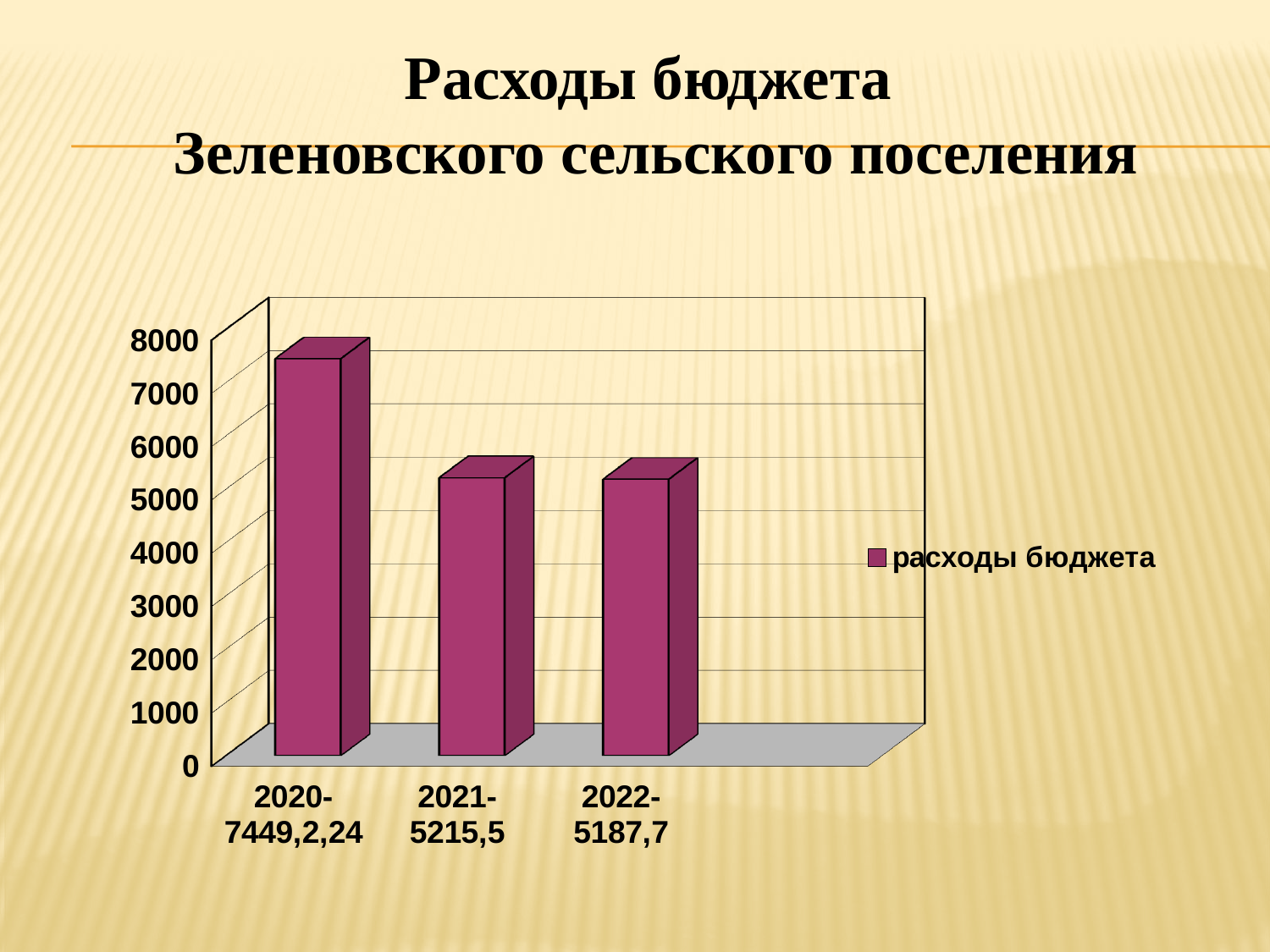
Which year has the highest budget expenditure in the chart? 2020 Is the value for 2022 greater or less than 6000? less Is the value for 2020 greater or less than 7000? greater What kind of chart is shown on the slide? bar chart Is the value for 2021 greater or less than 5000? greater Do the values rise or fall from 2020 to 2022 along the x axis? fall How many series does the legend list? 1 How many bars (categories) are plotted in the chart? 3 What value is printed in the category label for 2022? 5187,7 Which is larger, the value for 2020 or the value for 2021? 2020 What value is printed in the category label for 2021? 5215,5 What is the name of the series shown in the legend? расходы бюджета